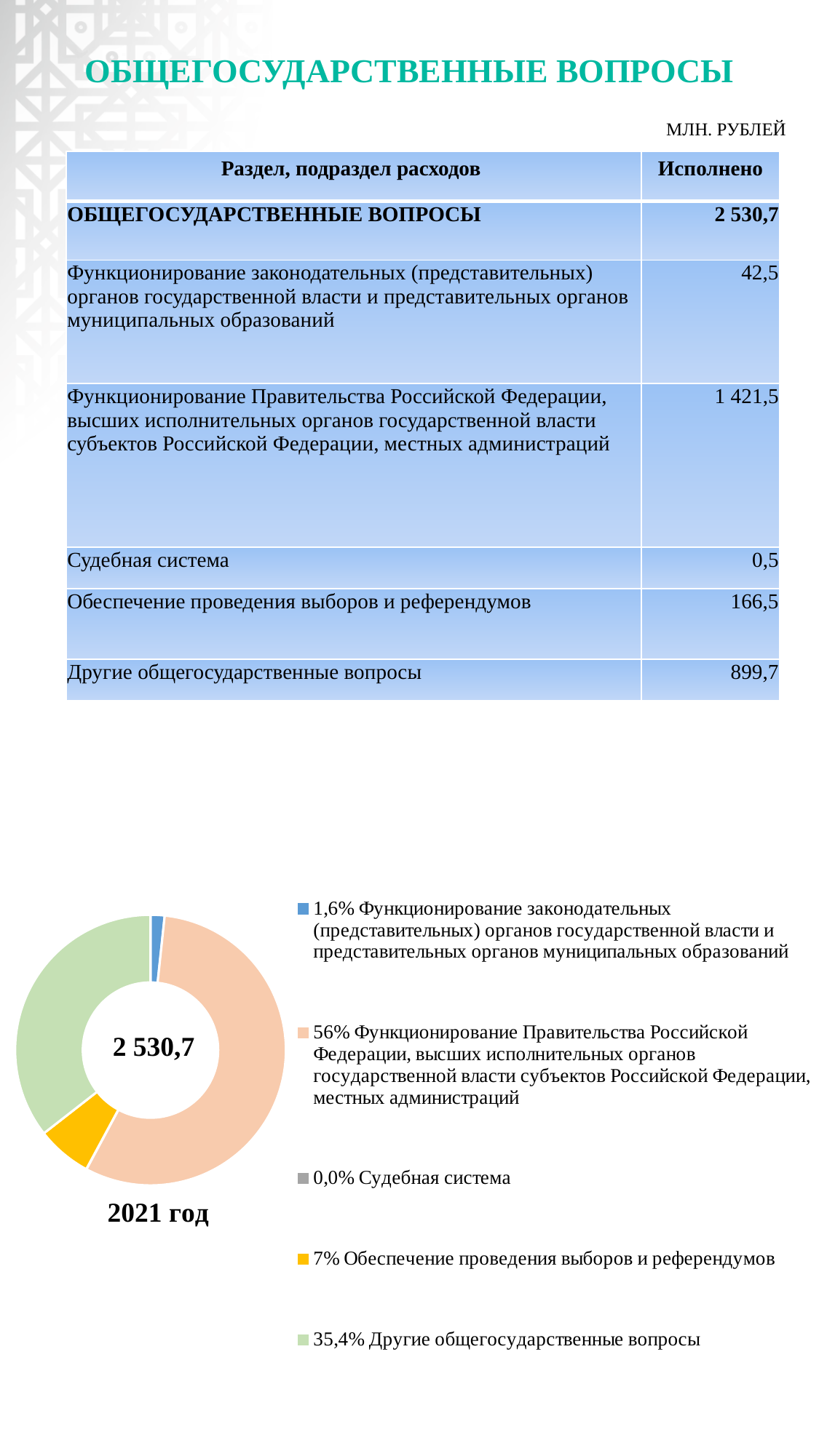
Which share is larger in the doughnut chart: "Другие общегосударственные вопросы" or "Обеспечение проведения выборов и референдумов"? Другие общегосударственные вопросы What share of the doughnut chart does "Судебная система" take? 0,0% Which category has the smallest share in the doughnut chart? Судебная система What share of the doughnut chart does "Другие общегосударственные вопросы" take? 35,4% Which category has the largest share in the doughnut chart? Функционирование Правительства Российской Федерации, высших исполнительных органов государственной власти субъектов Российской Федерации, местных администраций How many categories does the legend of the doughnut chart list? 5 What share of the doughnut chart does "Функционирование законодательных (представительных) органов государственной власти и представительных органов муниципальных образований" take? 1,6% What is the difference in percentage points between the share of "Функционирование Правительства Российской Федерации..." (56%) and "Другие общегосударственные вопросы" (35,4%)? 20,6 What value is printed in the centre of the doughnut chart? 2 530,7 What kind of chart is shown on the slide? doughnut (pie) chart What year is labelled under the doughnut chart? 2021 год